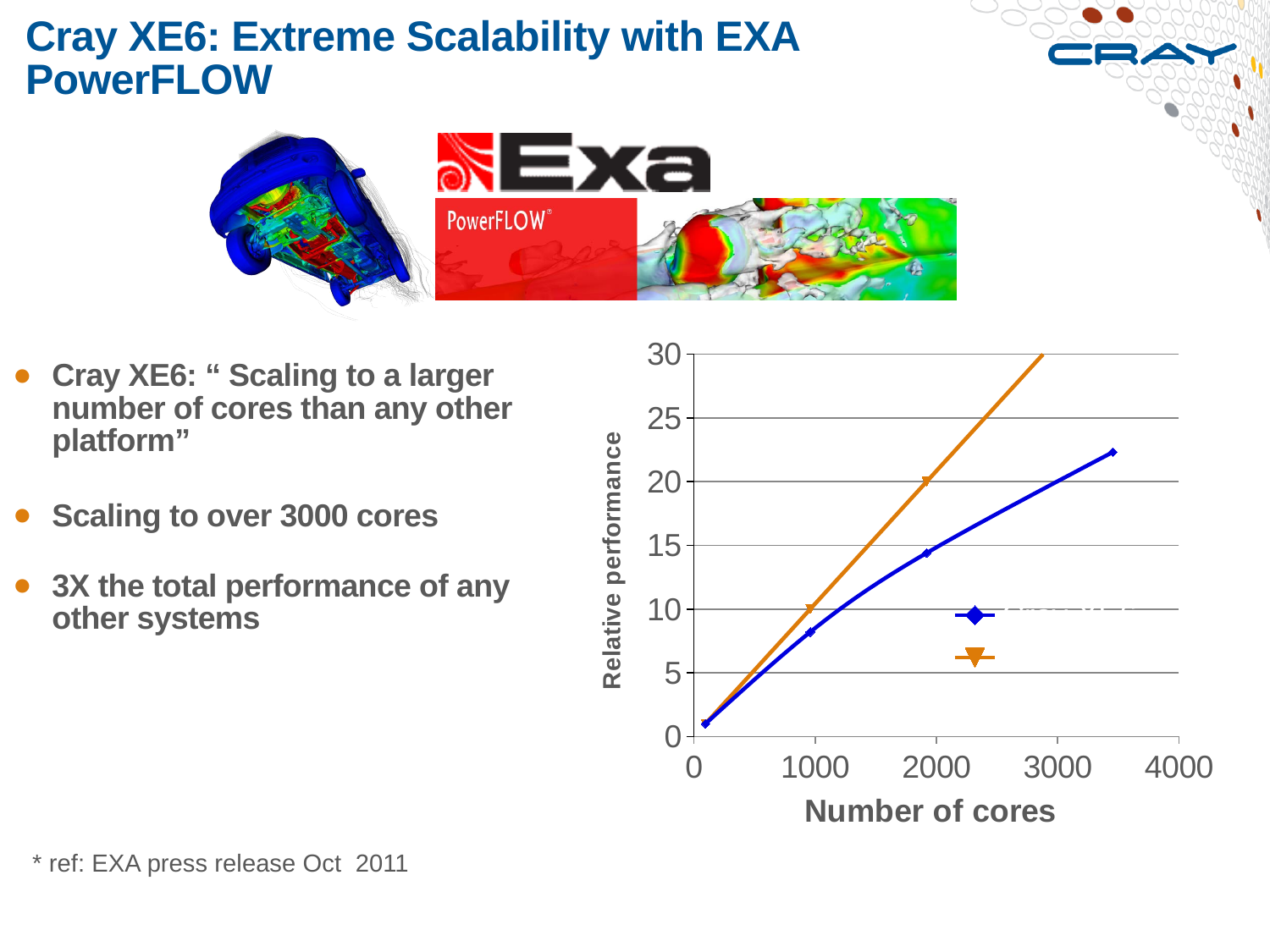
What is the maximum value shown on the x axis of the chart? 4000 At 2000 cores, which line has the higher relative performance, the blue line or the orange line? the orange line How many series are plotted on the chart? 2 Is the value of the blue line at 2500 cores greater or less than 15? greater How many data points are marked on the blue line? 4 What kind of chart is shown on the slide? line chart Is the value of the blue line at 1000 cores greater or less than 10? less Is the value of the blue line at 3500 cores greater or less than 25? less What is the title of the x axis of the chart? Number of cores What is the title of the y axis of the chart? Relative performance Do the values of the blue line rise or fall as the number of cores increases? rise